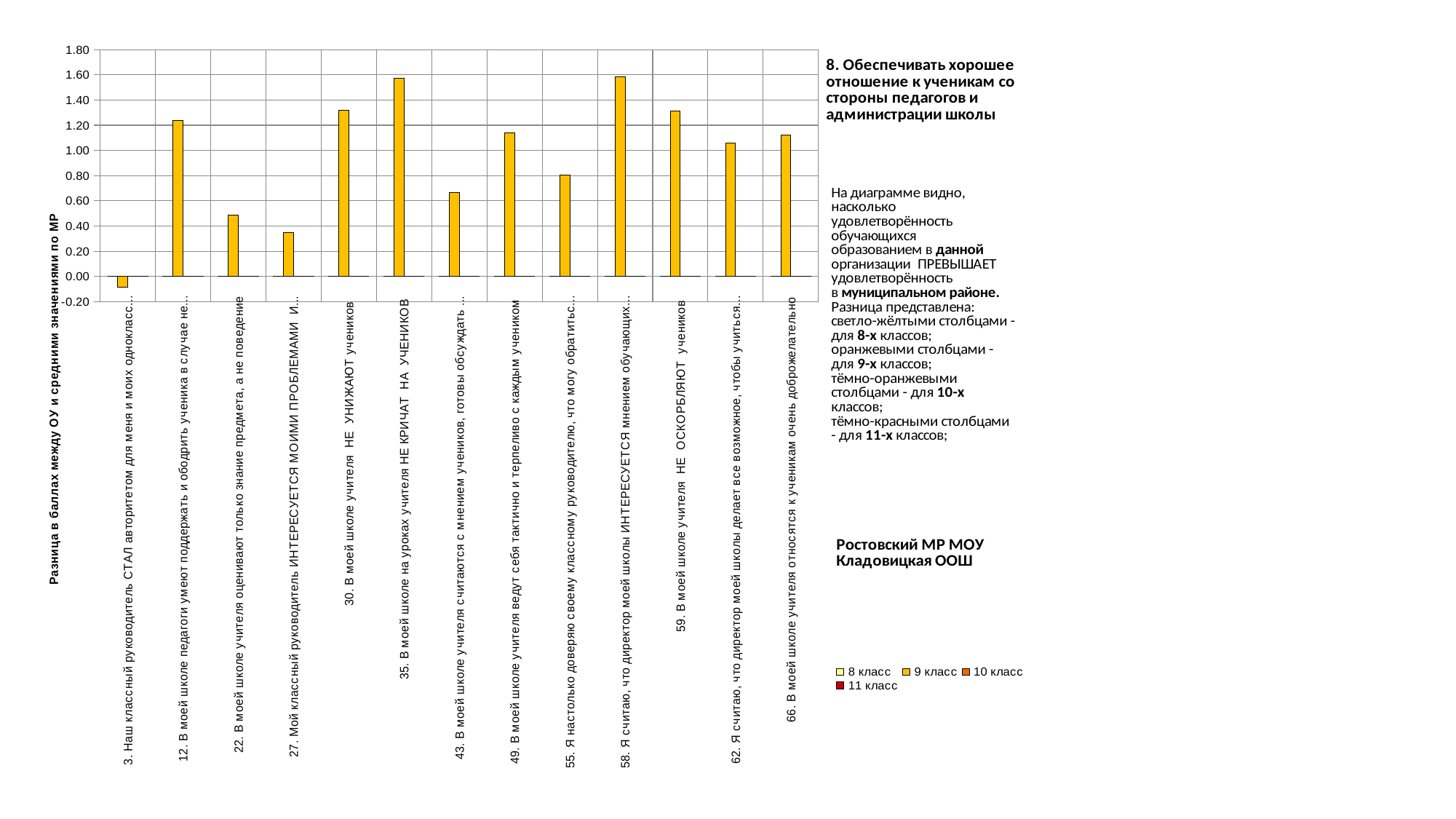
What are the four entries listed in the chart's legend? 8 класс, 9 класс, 10 класс, 11 класс Which has the larger value: statement 3 (классный руководитель СТАЛ авторитетом) or statement 55 (Я настолько доверяю своему классному руководителю...)? statement 55 Is the value for statement 27 (Мой классный руководитель ИНТЕРЕСУЕТСЯ МОИМИ ПРОБЛЕМАМИ...) greater or less than 0.60? less Is the value for statement 12 (В моей школе педагоги умеют поддержать и ободрить ученика...) greater or less than 1.00? greater Is the value for statement 66 (В моей школе учителя относятся к ученикам очень доброжелательно) greater or less than 1.00? greater Which has the larger value: statement 35 (учителя НЕ КРИЧАТ НА УЧЕНИКОВ) or statement 22 (учителя оценивают только знание предмета)? statement 35 How many categories (statements) are plotted along the x axis of the chart? 13 How many series does the chart's legend list? 4 Which category has the lowest value in the chart? 3. Наш классный руководитель СТАЛ авторитетом для меня и моих одноклассников What kind of chart is shown on the slide? bar chart